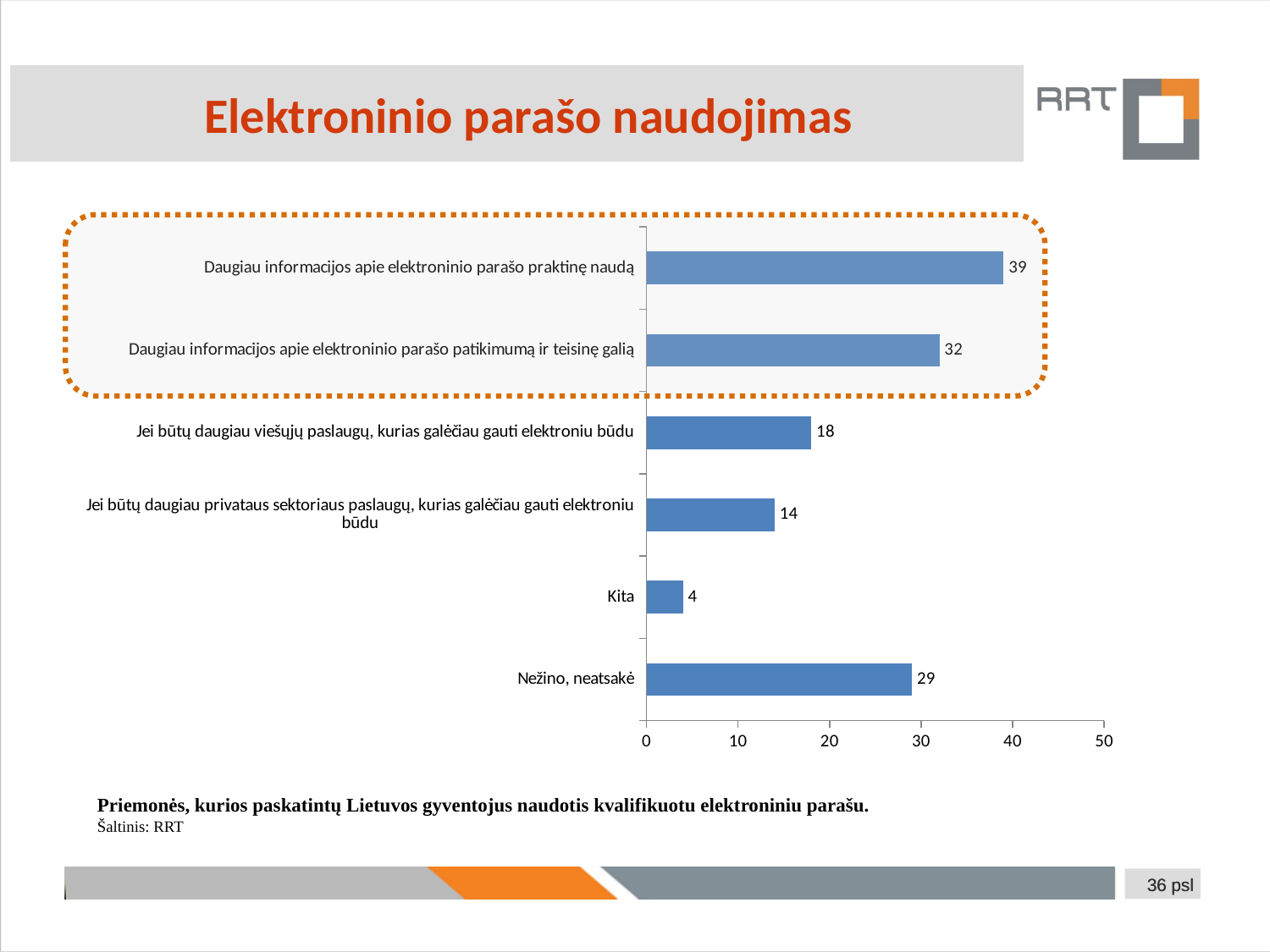
What is the maximum value shown on the horizontal axis? 50 Is the value for "Jei būtų daugiau privataus sektoriaus paslaugų, kurias galėčiau gauti elektroniu būdu" greater or less than 20? less Which category has the highest value? Daugiau informacijos apie elektroninio parašo praktinę naudą Which category has the lowest value? Kita What is the difference between the values for "Daugiau informacijos apie elektroninio parašo praktinę naudą" and "Daugiau informacijos apie elektroninio parašo patikimumą ir teisinę galią"? 7 How many categories are shown in the chart? 6 Which is larger: the value for "Nežino, neatsakė" or the value for "Jei būtų daugiau viešųjų paslaugų, kurias galėčiau gauti elektroniu būdu"? Nežino, neatsakė What is the value for "Kita"? 4 What kind of chart is shown on the slide? bar chart What is the value for "Jei būtų daugiau viešųjų paslaugų, kurias galėčiau gauti elektroniu būdu"? 18 What is the value for "Nežino, neatsakė"? 29 What is the value for "Daugiau informacijos apie elektroninio parašo praktinę naudą"? 39